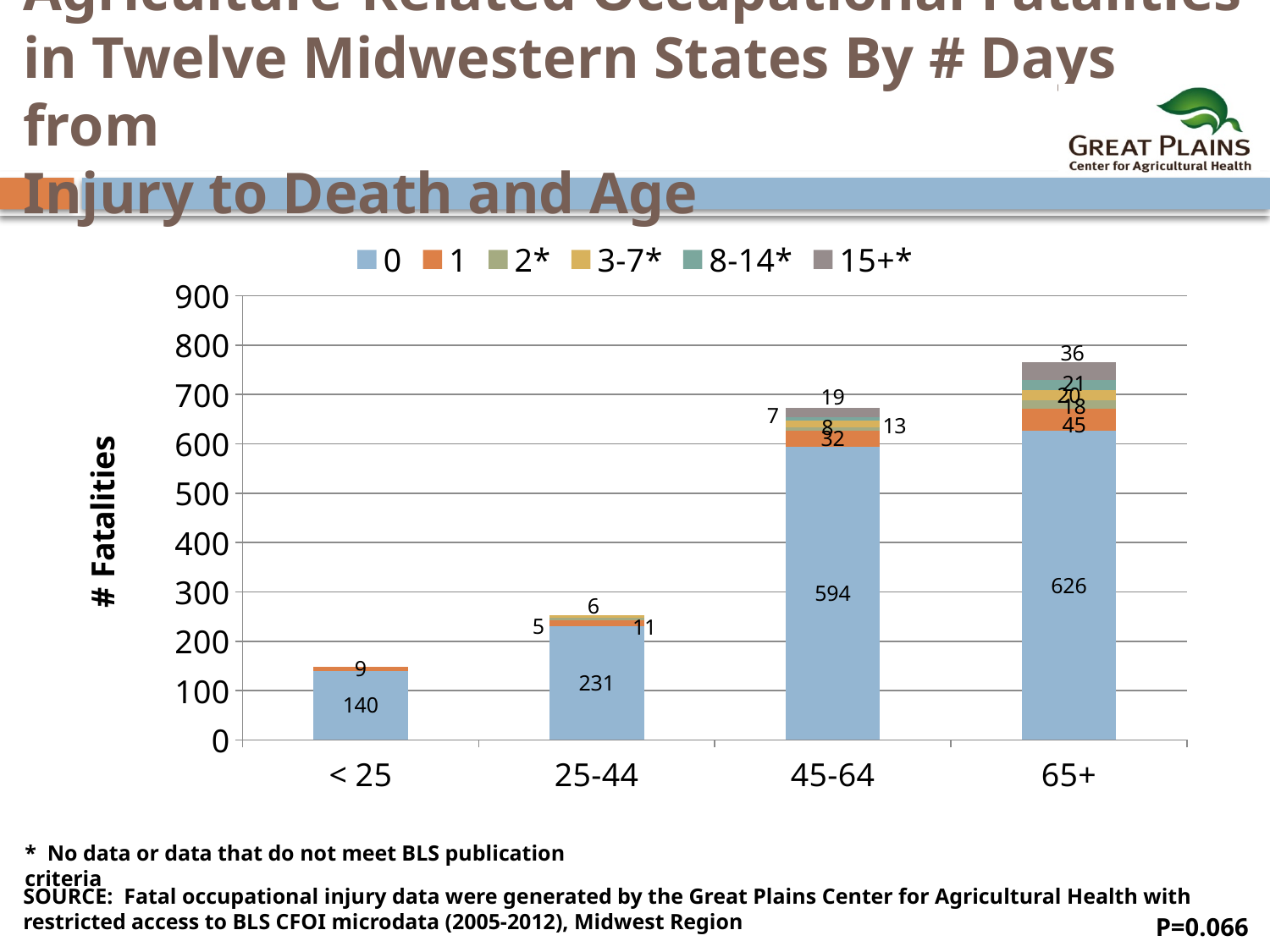
Which age group has the highest value for the '0' days series? 65+ Which age group has the lowest value for the '0' days series? < 25 What is the difference between the '0' days values for the 65+ and 45-64 age groups? 32 What is the value of the '15+*' series for the 65+ age group? 36 What is the value of the '0' days series for the < 25 age group? 140 Do the total fatalities rise or fall as age group increases along the x axis? rise What kind of chart is shown on the slide? stacked bar chart What is the value of the '1' day series for the 45-64 age group? 32 What is the value of the '0' days series for the 65+ age group? 626 How many series does the legend list? 6 Is the total height of the 65+ bar greater or less than 700? greater How many age groups are shown on the x axis? 4